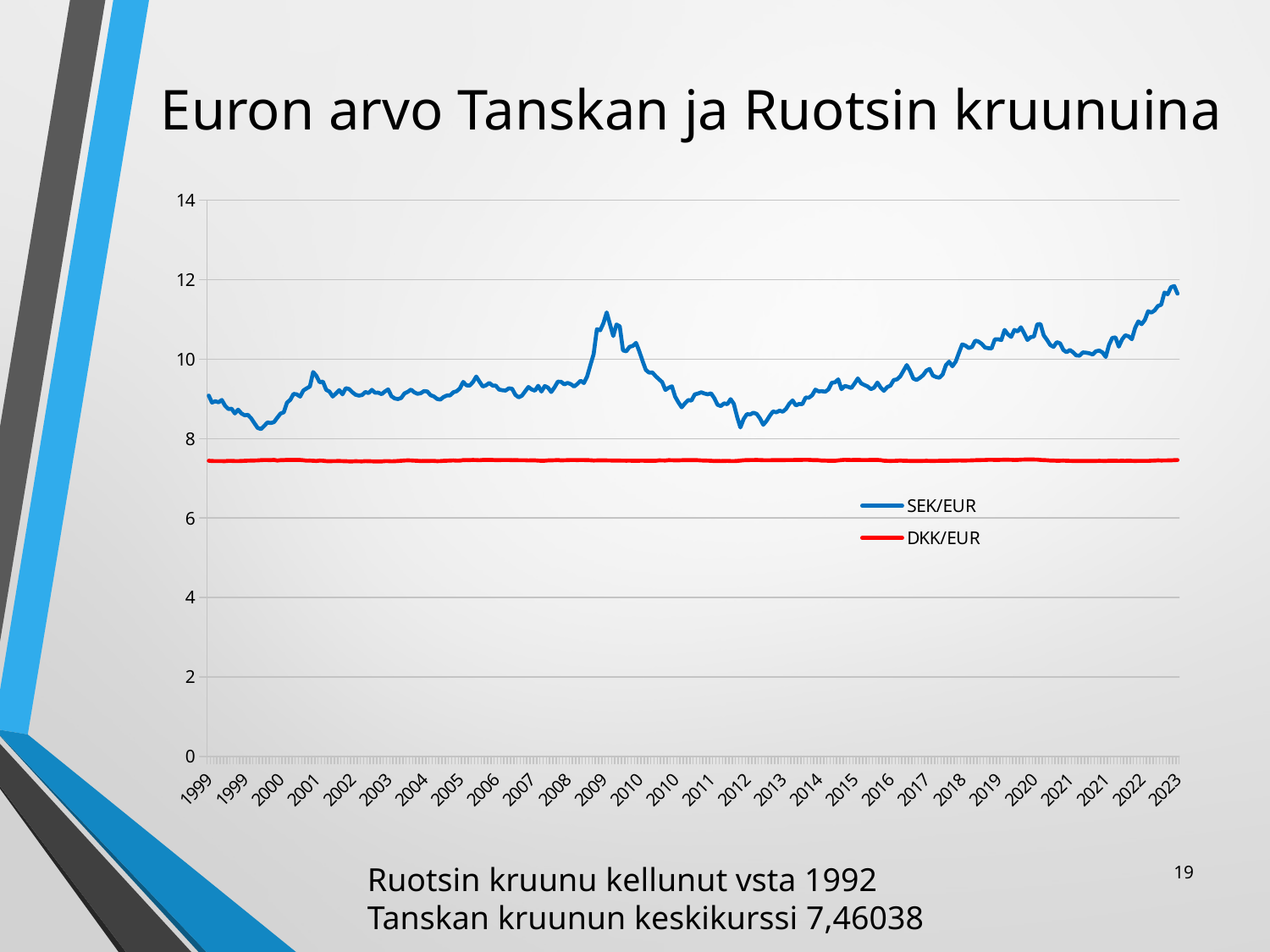
How many series does the legend list? 2 Does the SEK/EUR line rise or fall between 2021 and 2023? rises Which series stays nearly flat across the whole period? DKK/EUR What is the title of the chart on the slide? Euron arvo Tanskan ja Ruotsin kruunuina Which series is drawn in red? DKK/EUR Is the value of DKK/EUR greater or less than 8? less What kind of chart is shown on the slide? Line chart Does the SEK/EUR line rise or fall between its 2009 peak and 2012? falls Which series has the higher values throughout the chart, SEK/EUR or DKK/EUR? SEK/EUR Is the value of SEK/EUR in 2012 greater or less than 10? less Is the value of SEK/EUR at the end of 2023 greater or less than 10? greater